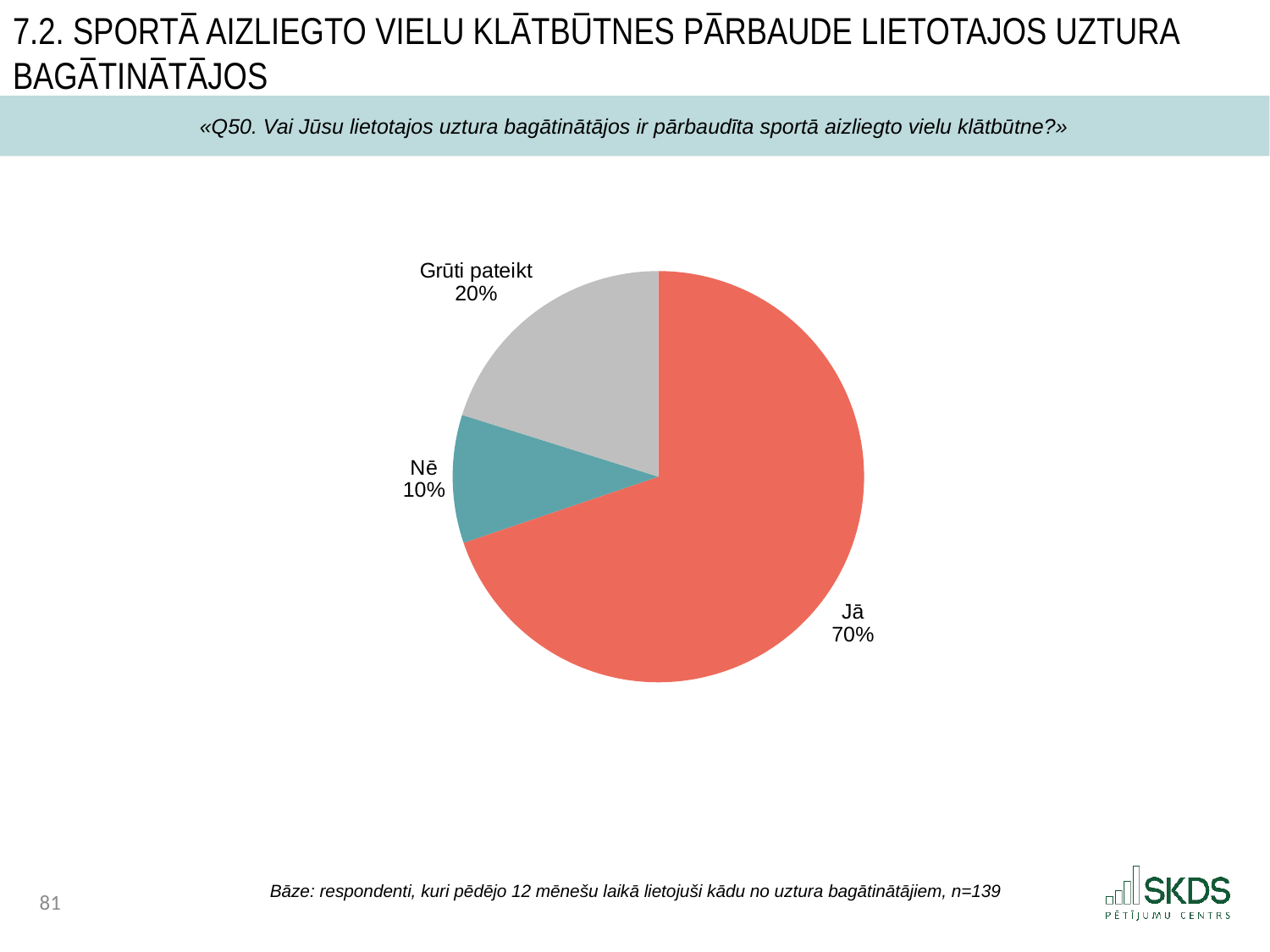
Which answer has the largest slice of the pie? Jā What share of respondents answered "Grūti pateikt"? 20% Which is larger, the share for "Nē" or the share for "Grūti pateikt"? Grūti pateikt What is the difference in percentage points between "Grūti pateikt" and "Nē"? 10 How many slices does the pie chart have? 3 What is the difference in percentage points between "Jā" and "Grūti pateikt"? 50 What is the sample size (n) stated in the base note below the chart? n=139 What share of respondents answered "Nē"? 10% What colour is the "Jā" slice of the pie? red What kind of chart is shown on the slide? pie chart Which answer has the smallest slice of the pie? Nē What share of respondents answered "Jā"? 70%